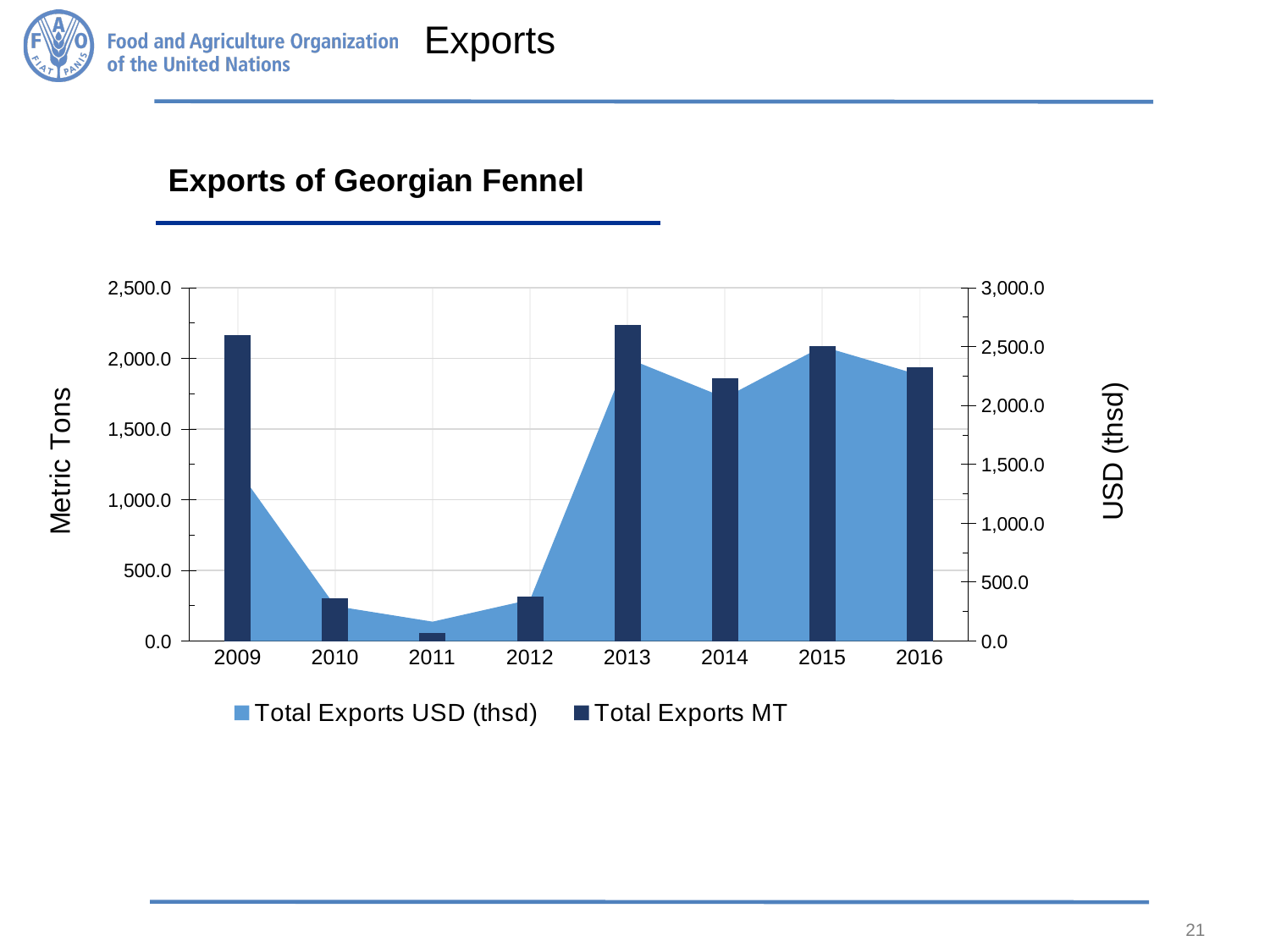
Which series is drawn as bars in the chart? Total Exports MT Is the Total Exports USD (thsd) value for 2015 greater or less than 2,000.0? greater Is the Total Exports MT value for 2009 greater or less than 2,000.0? greater Which year has the highest Total Exports MT bar? 2013 Does Total Exports MT rise or fall from 2009 to 2011? fall Is the Total Exports MT value for 2010 greater or less than 500.0? less Which year has the lowest Total Exports MT bar? 2011 How many series does the chart legend list? 2 Which year has the larger Total Exports MT bar, 2014 or 2015? 2015 What is the title of the chart? Exports of Georgian Fennel How many years are shown on the x axis of the chart? 8